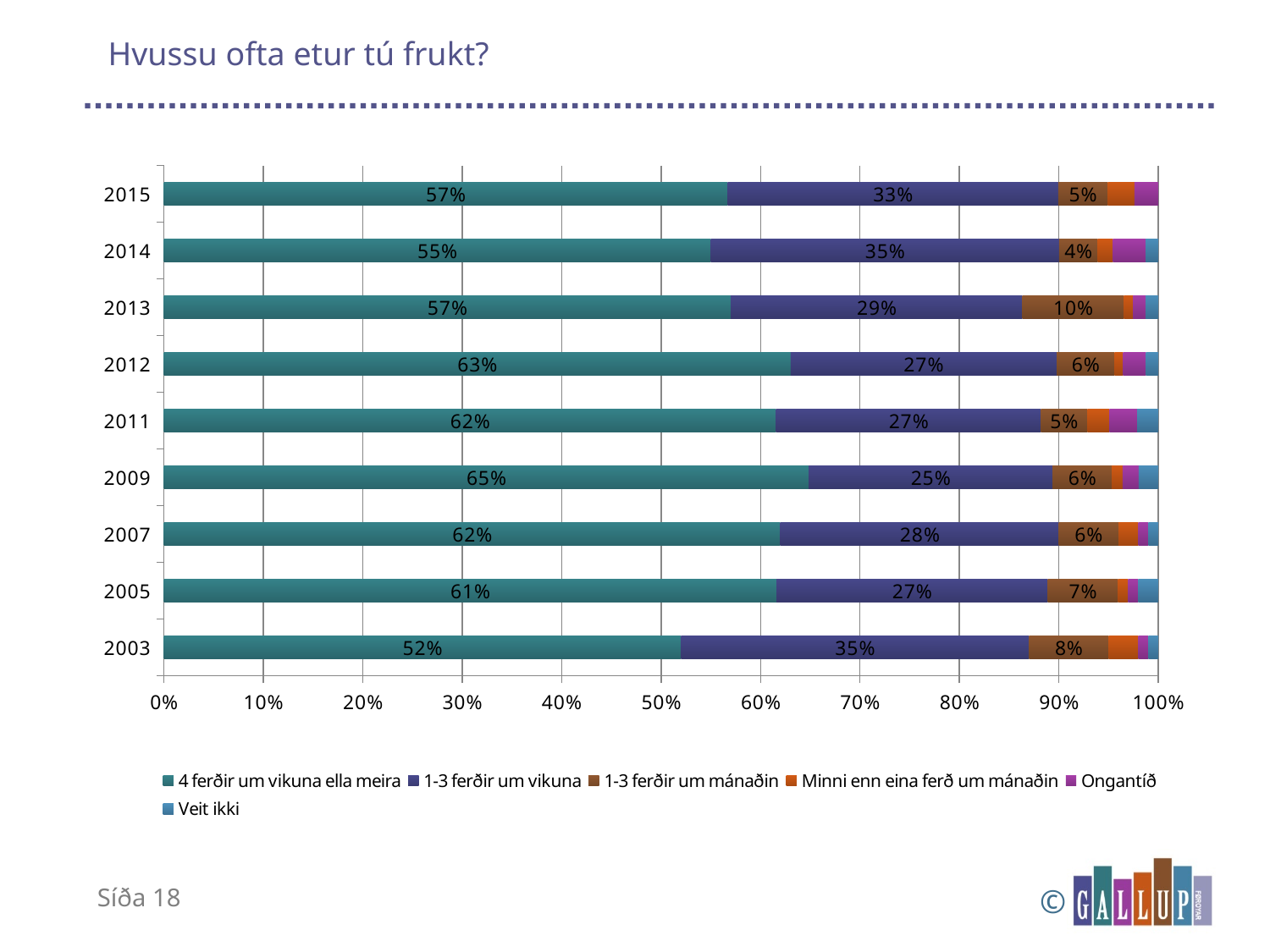
What is the difference between the "4 ferðir um vikuna ella meira" values for 2015 and 2003? 5 percentage points How many years are shown on the chart? 9 What is the value for "1-3 ferðir um vikuna" in 2003? 35% In which year is the share for "4 ferðir um vikuna ella meira" highest? 2009 What percentage of respondents in 2015 answered "4 ferðir um vikuna ella meira"? 57% In which year is the share for "4 ferðir um vikuna ella meira" lowest? 2003 Which is larger: the "1-3 ferðir um vikuna" value for 2014 or for 2013? 2014 How many series does the legend list? 6 What is the value for "1-3 ferðir um mánaðin" in 2013? 10% What kind of chart is shown on the slide? Stacked bar chart In which year is the share for "1-3 ferðir um mánaðin" lowest? 2014 What is the title of the slide? Hvussu ofta etur tú frukt?